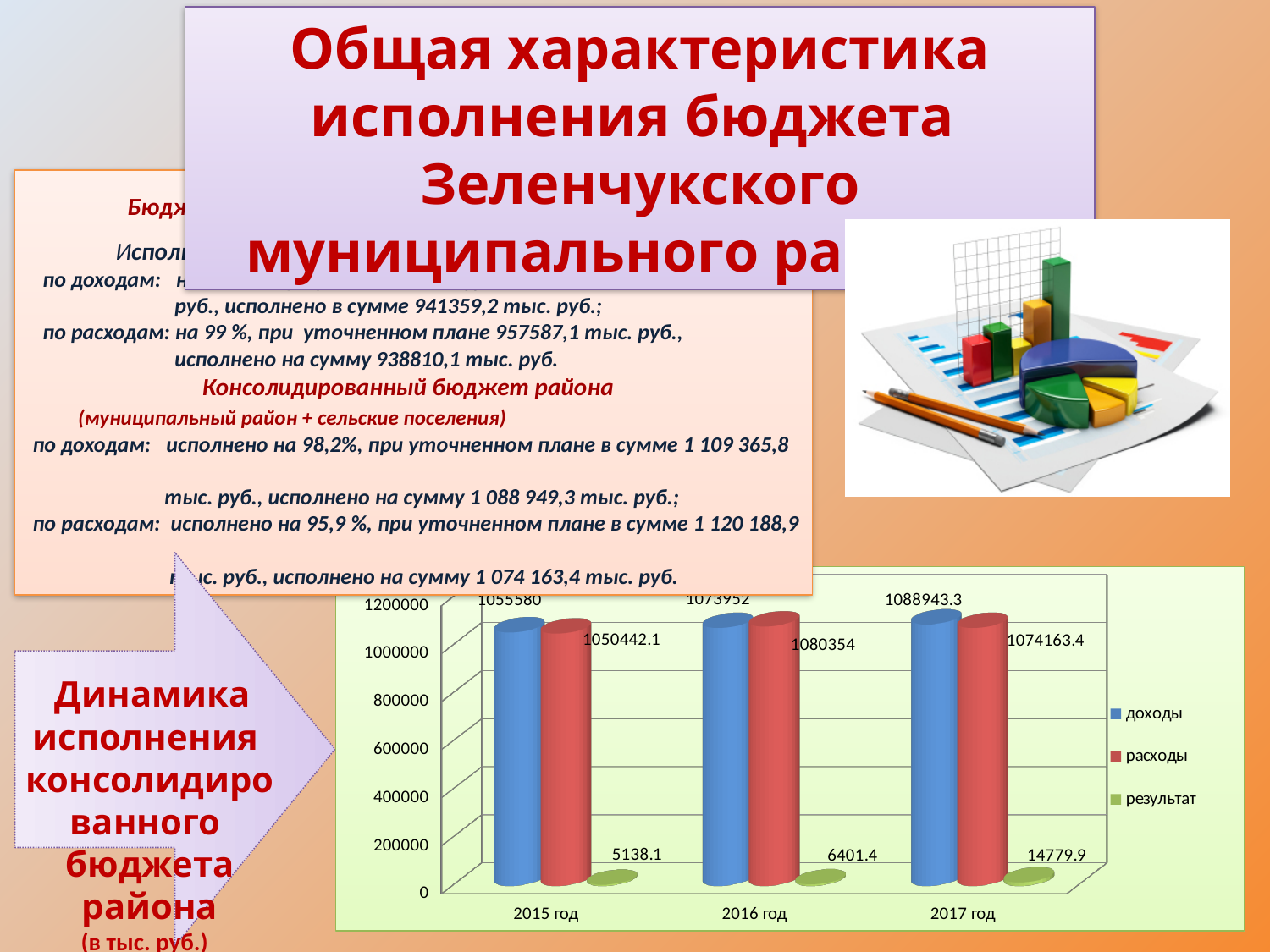
What is the difference between результат in 2017 год and результат in 2016 год? 8378.5 In which year is результат the lowest? 2015 год Which is larger in 2016 год: доходы or расходы? расходы What kind of chart is shown on the slide? bar chart In which year is доходы the highest? 2017 год Does the value of доходы rise or fall from 2015 год to 2017 год? rise What is the value of результат for 2016 год? 6401.4 How many years (categories) are shown on the x axis? 3 What is the value of расходы for 2017 год? 1074163.4 What is the value of доходы for 2015 год? 1055580 How many series does the legend list? 3 What is the value of расходы for 2016 год? 1080354